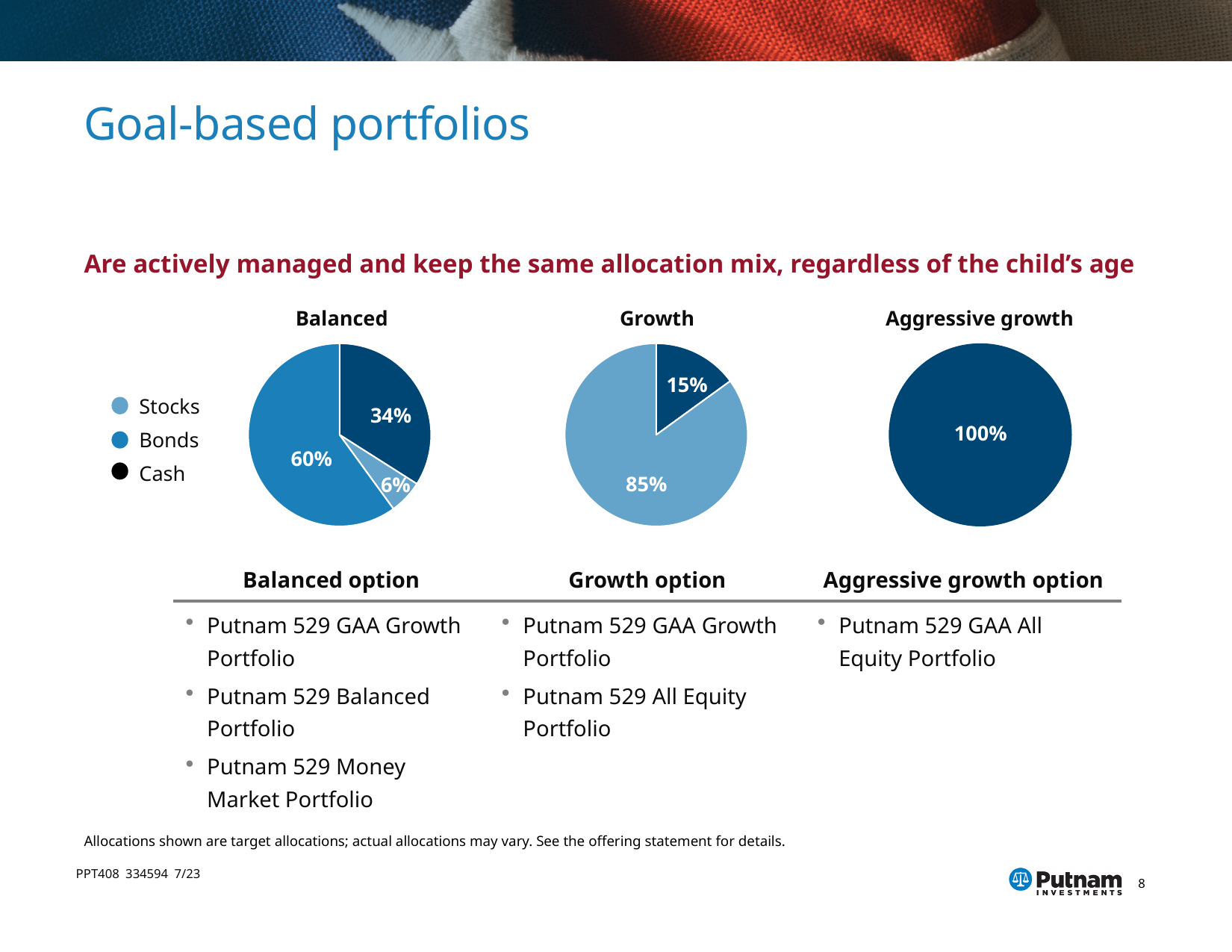
What is the smallest share shown in the Balanced pie chart? 6% In the Balanced pie chart, what is the difference between the 60% slice and the 34% slice? 26% What is the smallest share shown in the Growth pie chart? 15% In the Growth pie chart, what is the difference between the larger and smaller slices? 70% How many slices does the Growth pie chart have? 2 What is the largest share shown in the Balanced pie chart? 60% How many entries does the legend list? 3 What kind of charts are shown on the slide? Pie charts What is the largest share shown in the Growth pie chart? 85% What share is labelled on the Aggressive growth pie chart? 100% How many slices does the Balanced pie chart have? 3 What are the three entries in the legend? Stocks, Bonds, Cash